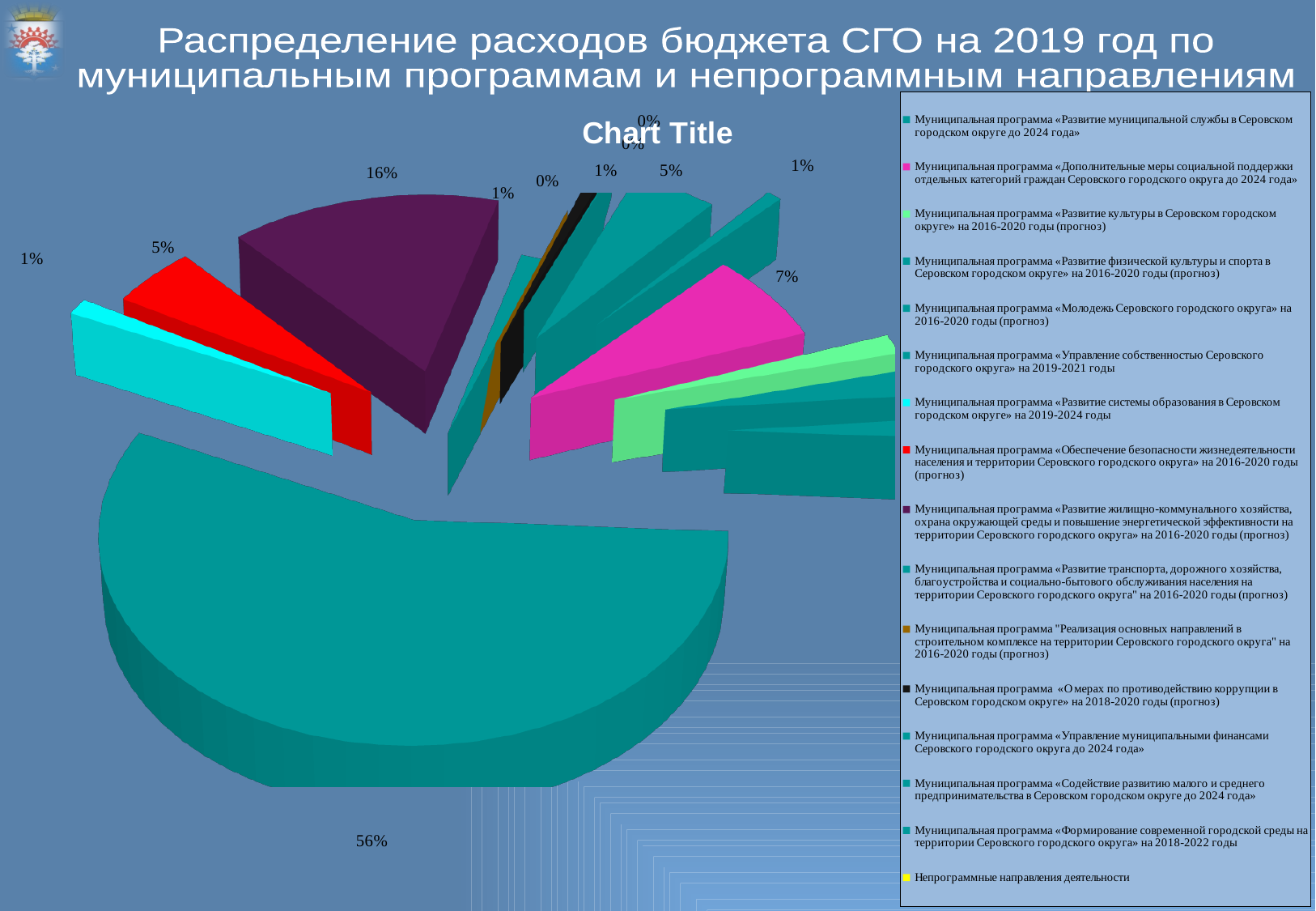
What is the difference in percentage points between the purple slice (16%) and the red slice (5%)? 11 percentage points What title is printed above the pie chart? Chart Title Which slice is larger, the purple slice or the red slice? the purple slice Is the largest slice of the pie chart greater or less than 50%? greater What share is shown for the purple slice (Муниципальная программа «Развитие жилищно-коммунального хозяйства...»)? 16% Which legend entry is marked with a yellow colour? Непрограммные направления деятельности Which slice is larger, the magenta slice or the purple slice? the purple slice What share does the largest slice of the pie chart represent? 56% What kind of chart is shown on the slide? pie chart How many entries does the legend of the pie chart list? 16 What share is shown for the red slice (Муниципальная программа «Обеспечение безопасности жизнедеятельности...»)? 5%